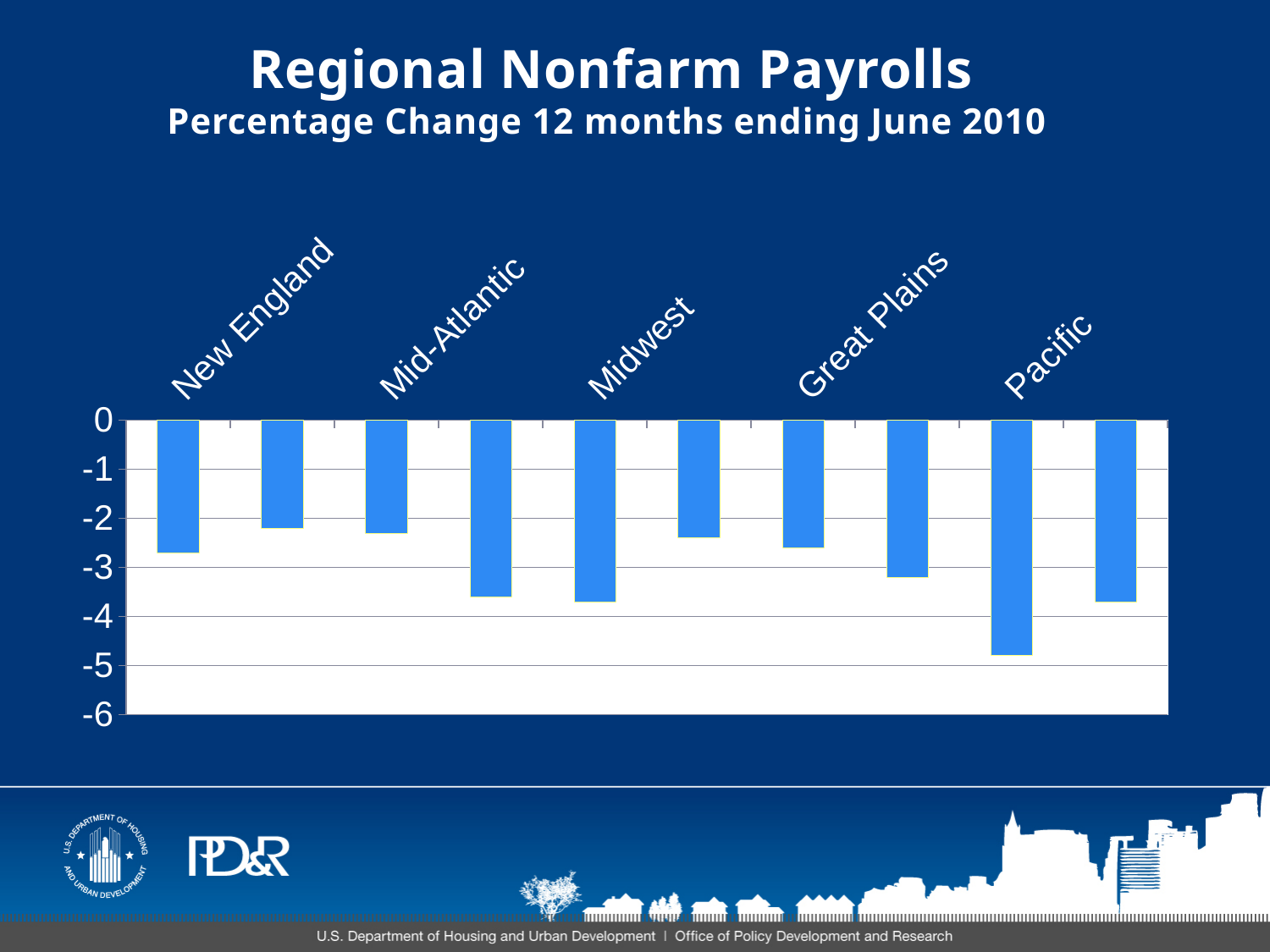
Is the value for Great Plains greater or less than -2? less Is the value for Midwest greater or less than -3? less Which has the larger (less negative) value, Mid-Atlantic or Midwest? Mid-Atlantic Is the value for Pacific greater or less than -4? less How many bars are plotted in the chart? 10 Which labeled region has the lowest (most negative) value? Pacific What kind of chart is shown on the slide? bar chart Which has the larger (less negative) value, New England or Pacific? New England What period does the chart's subtitle say the percentage change covers? 12 months ending June 2010 What is the title of the chart? Regional Nonfarm Payrolls